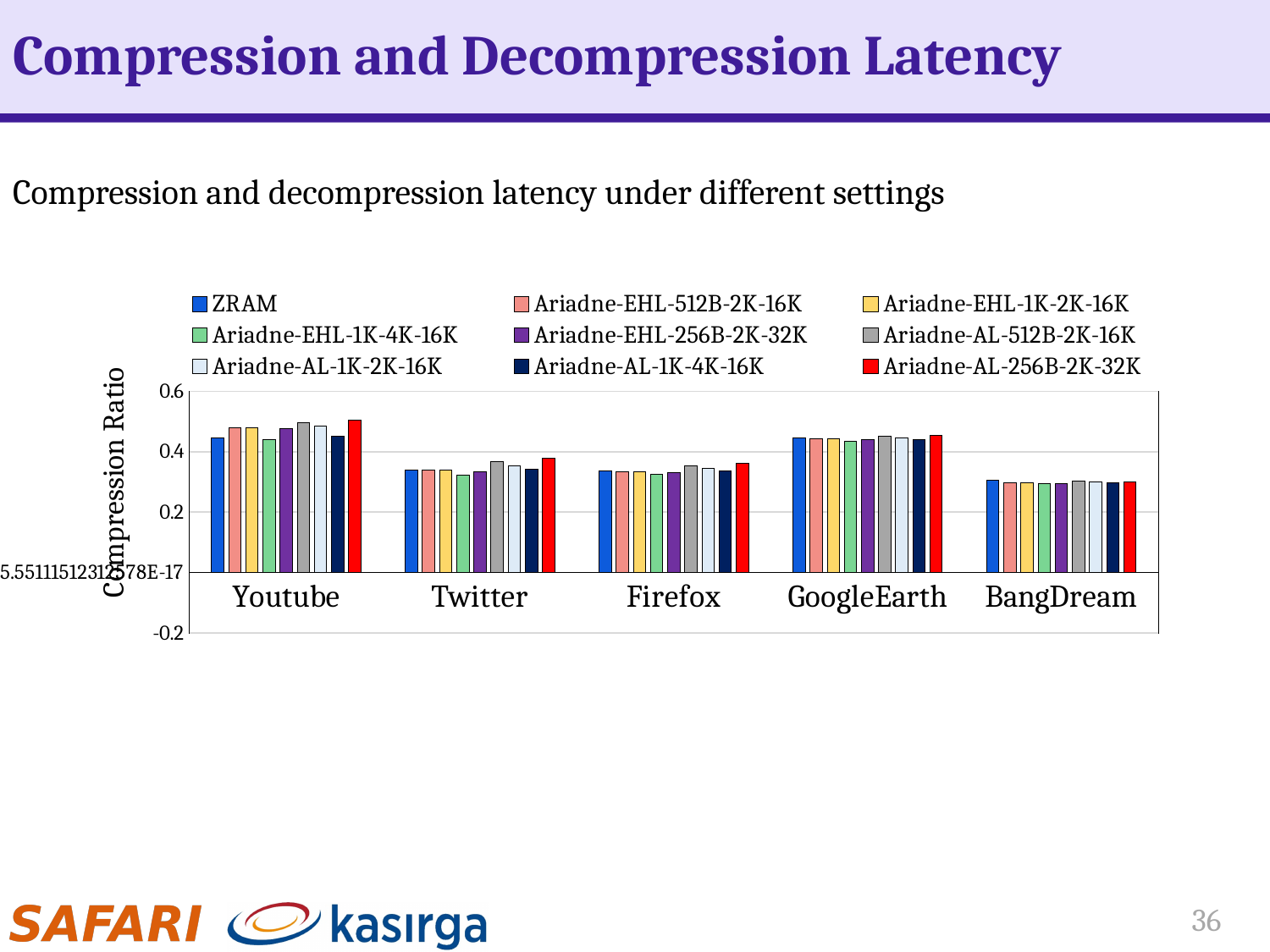
Is the ZRAM value for Twitter greater or less than 0.4? less What kind of chart is shown on the slide? bar chart What colour represents the Ariadne-AL-256B-2K-32K series in the legend? red How many categories are shown on the x axis of the chart? 5 Which category has the lowest ZRAM value? BangDream How many series does the chart's legend list? 9 Is the ZRAM value for BangDream greater or less than 0.2? greater What is the label on the y axis of the chart? Compression Ratio Which is larger, the Ariadne-AL-256B-2K-32K value for Youtube or for GoogleEarth? Youtube Is the ZRAM value for Youtube greater or less than 0.4? greater Which is larger, the ZRAM value for Youtube or the ZRAM value for Twitter? Youtube